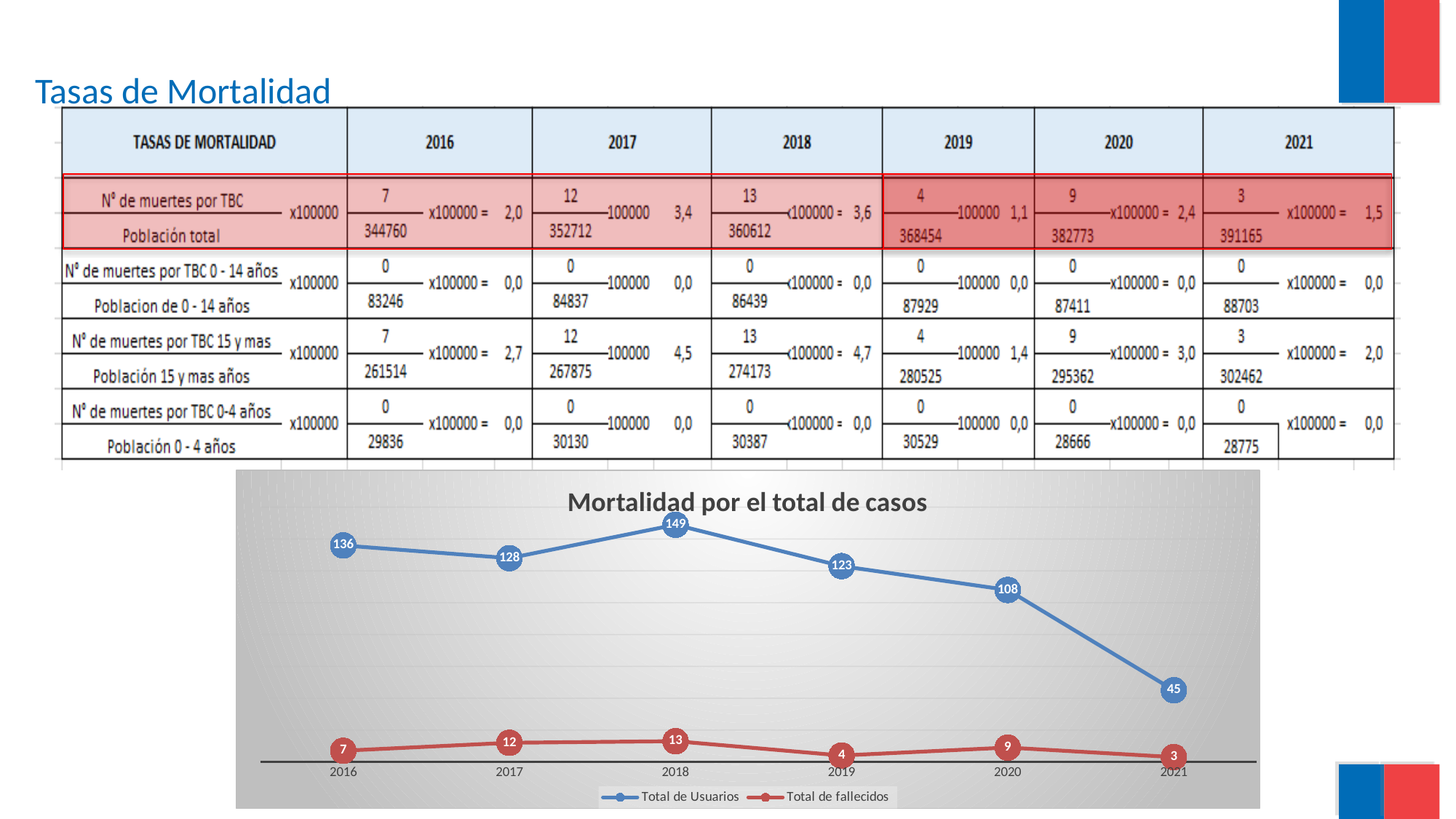
What kind of chart is shown on the slide? line chart What is the value of Total de Usuarios in 2021? 45 In which year is Total de fallecidos lowest? 2021 Does Total de Usuarios rise or fall from 2018 to 2021? fall Which is larger: Total de fallecidos in 2017 or in 2020? 2017 What is the value of Total de fallecidos in 2019? 4 How many years are shown on the x axis of the chart? 6 What is the value of Total de Usuarios in 2018? 149 What is the title of the chart? Mortalidad por el total de casos How many series does the chart legend list? 2 In which year is Total de Usuarios highest? 2018 What is the difference between Total de Usuarios in 2020 and in 2021? 63